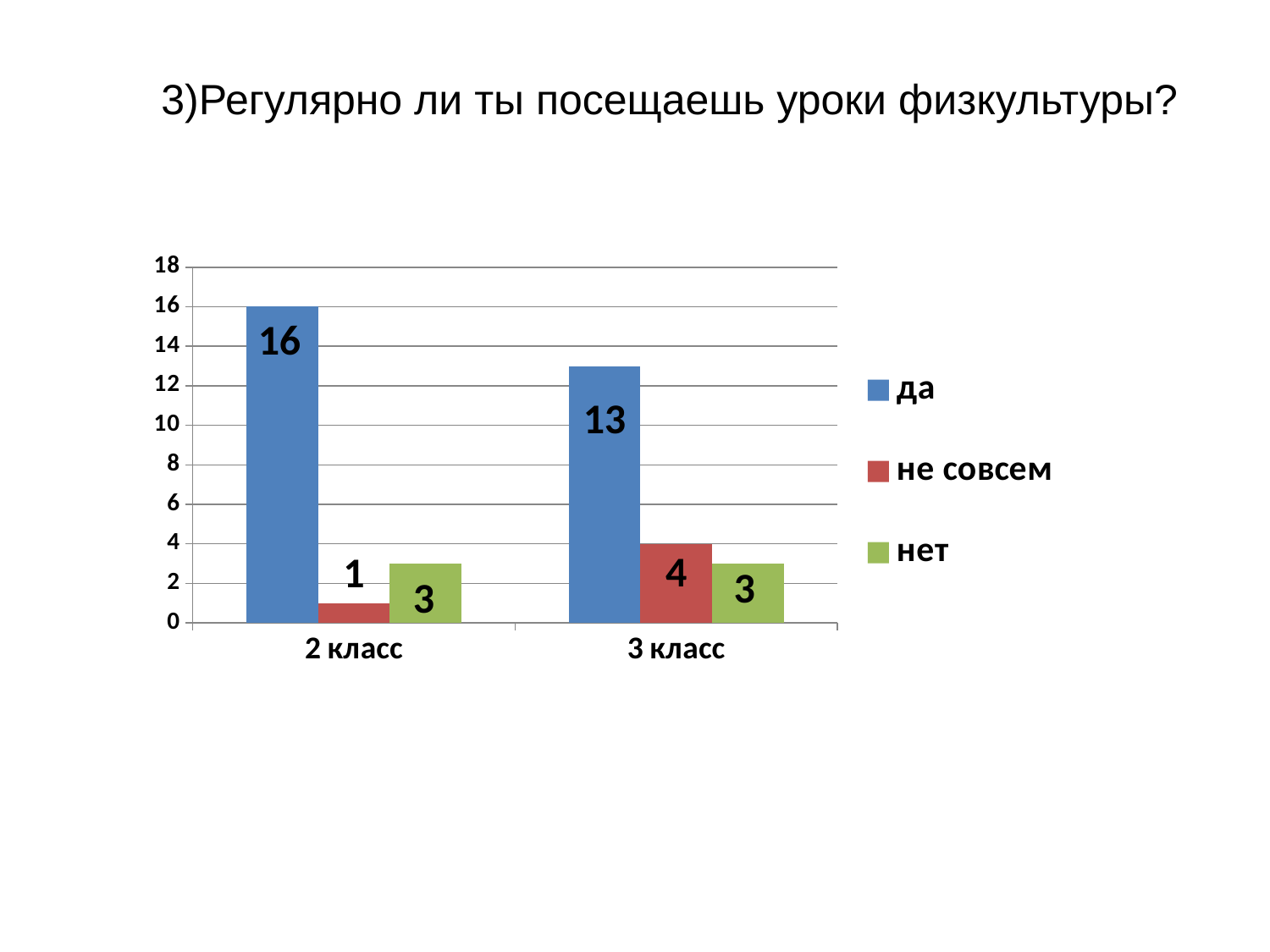
Which is larger: "не совсем" in "2 класс" or "не совсем" in "3 класс"? 3 класс Which series has the lowest value in "2 класс"? не совсем What is the difference between the "да" values for "2 класс" and "3 класс"? 3 What is the value for "нет" in "2 класс"? 3 Which series has the highest value in "3 класс"? да How many categories are shown on the x axis? 2 What is the value for "да" in "3 класс"? 13 What is the value for "не совсем" in "3 класс"? 4 What kind of chart is shown on the slide? bar chart How many series does the legend list? 3 What is the value for "да" in "2 класс"? 16 What colour represents the "нет" series? green